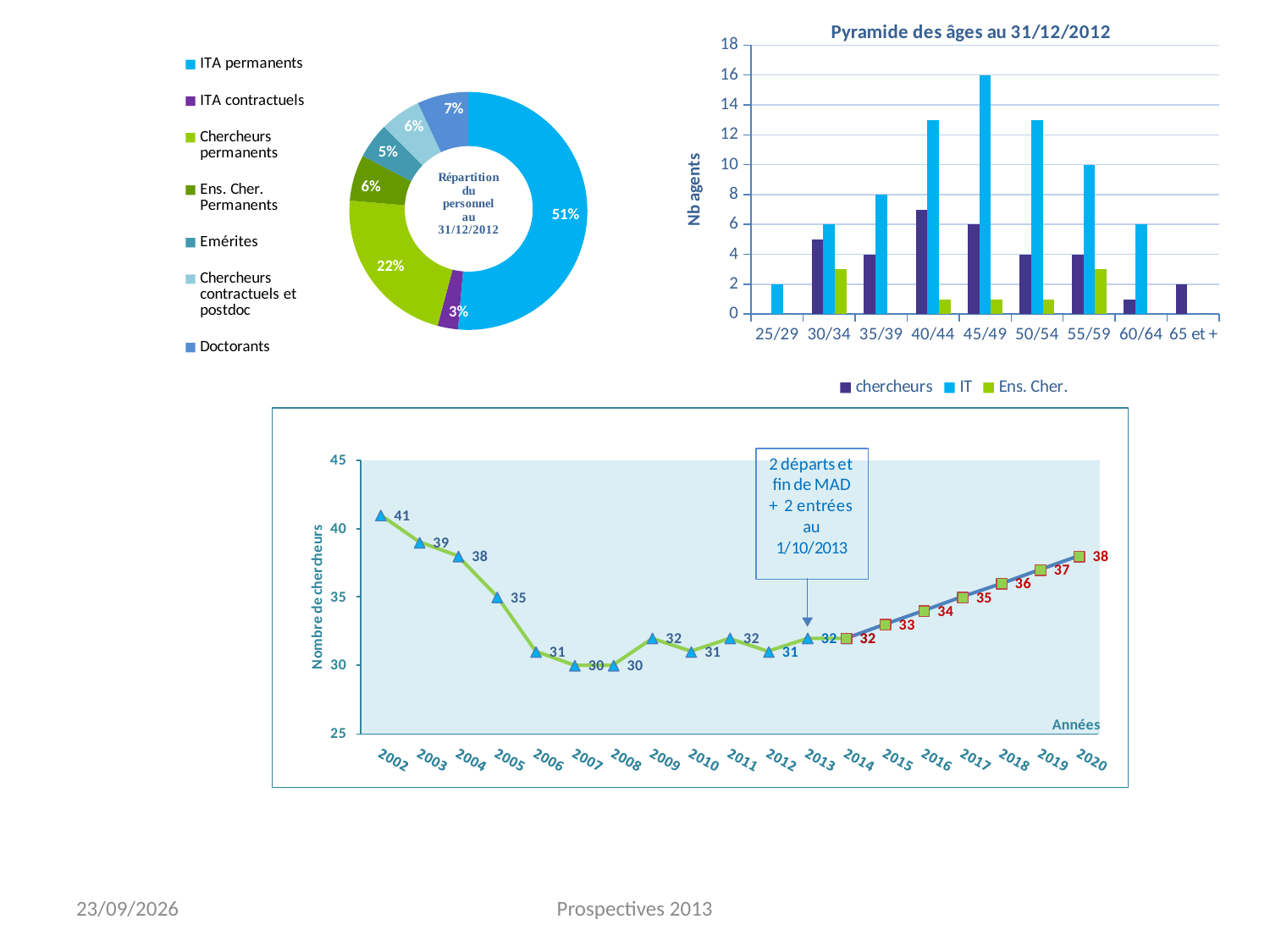
In the chart 'Pyramide des âges au 31/12/2012', is the chercheurs value for 40/44 greater or less than 6? greater In the doughnut chart 'Répartition du personnel au 31/12/2012', which category has the smallest share? ITA contractuels What kind of chart is 'Pyramide des âges au 31/12/2012'? bar chart In the doughnut chart 'Répartition du personnel au 31/12/2012', what share is Chercheurs permanents? 22% In the chart 'Pyramide des âges au 31/12/2012', what is the IT value for the 45/49 age group? 16 In the chart 'Pyramide des âges au 31/12/2012', which age group has the highest IT value? 45/49 In the bottom line chart of 'Nombre de chercheurs', what is the difference between the values for 2002 and 2007? 11 In the chart 'Pyramide des âges au 31/12/2012', how many series does the legend list? 3 How many categories does the legend of the doughnut chart 'Répartition du personnel au 31/12/2012' list? 7 In the bottom line chart of 'Nombre de chercheurs', do the values rise or fall from 2013 to 2020? rise In the bottom line chart of 'Nombre de chercheurs', what is the value for 2002? 41 In the doughnut chart 'Répartition du personnel au 31/12/2012', what share is ITA permanents? 51%